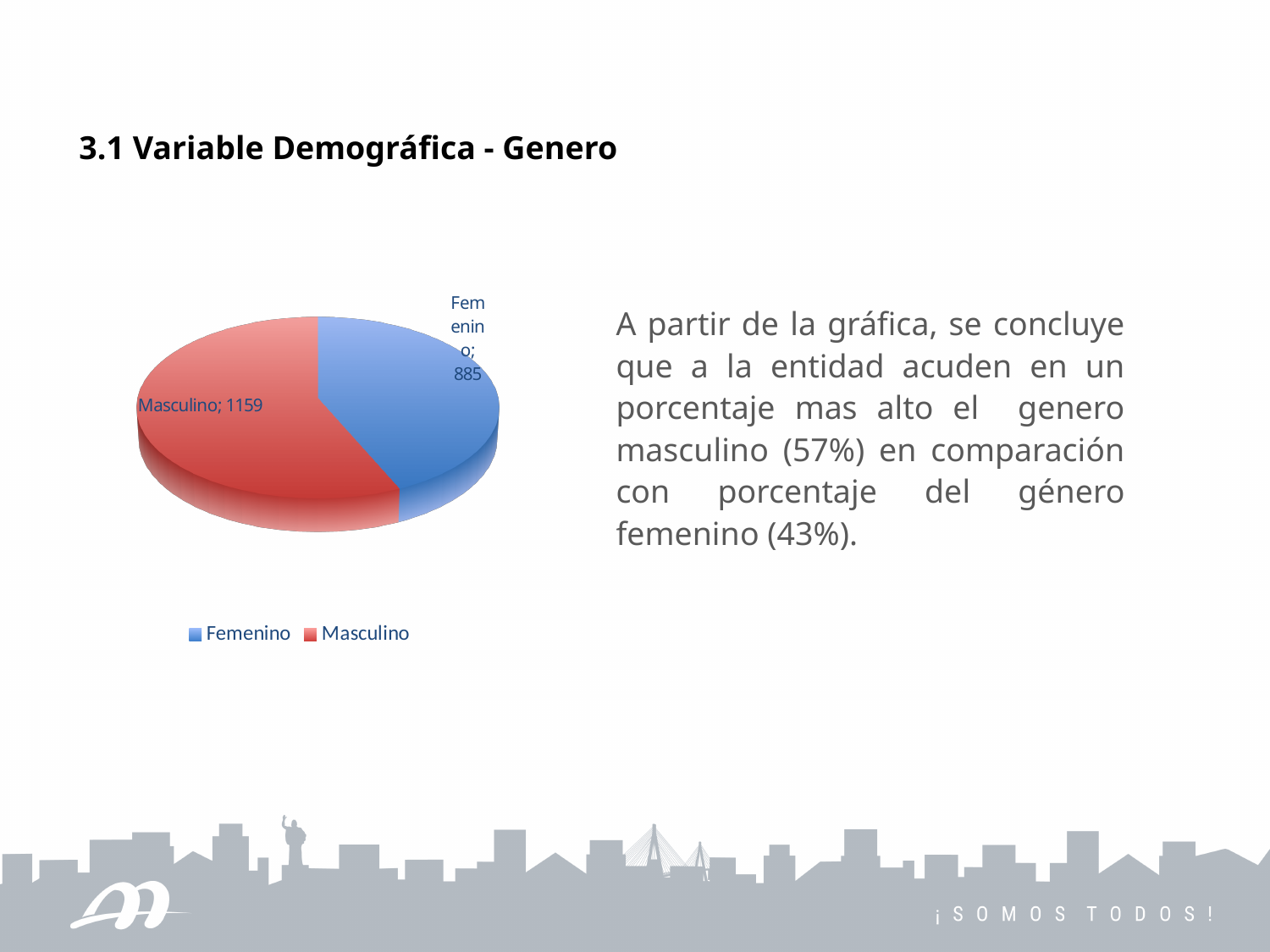
According to the slide, what percentage share does the Masculino slice represent? 57% What is the total of the two values shown in the pie chart? 2044 Which is larger, the value for Femenino or the value for Masculino? Masculino Which category has the largest slice in the pie chart? Masculino What is the value for Masculino in the pie chart? 1159 What colour is the Femenino slice in the pie chart? blue Which category has the smallest slice in the pie chart? Femenino How many entries does the legend of the pie chart list? 2 What is the difference between the Masculino and Femenino values? 274 What is the value for Femenino in the pie chart? 885 What kind of chart is shown on the slide? pie chart How many slices does the pie chart have? 2